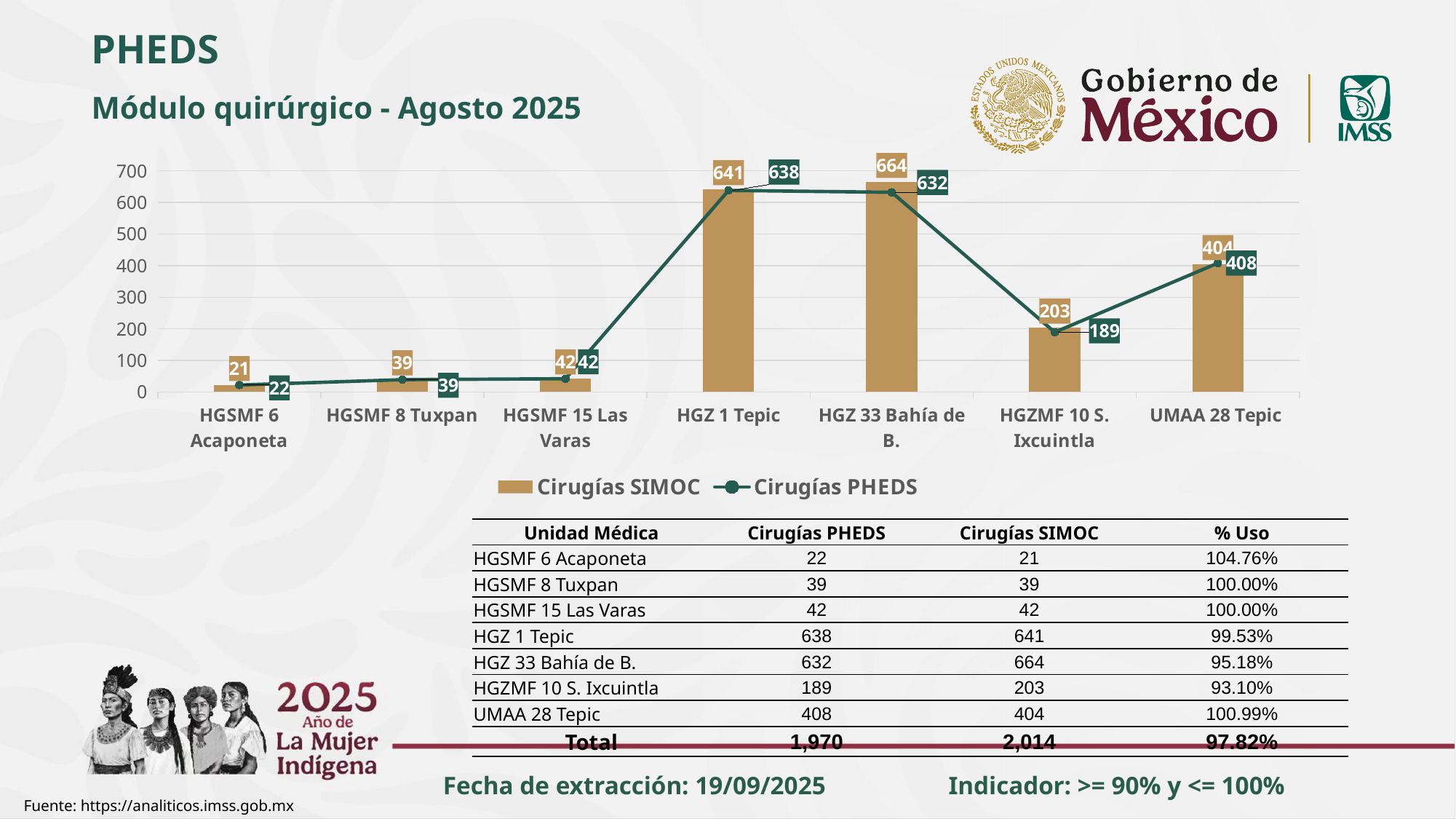
What kind of chart is used to show Cirugías SIMOC? Bar chart What is the Cirugías PHEDS value for HGZMF 10 S. Ixcuintla? 189 Which series is drawn as a line in the chart? Cirugías PHEDS What is the difference between Cirugías SIMOC and Cirugías PHEDS for HGZ 33 Bahía de B.? 32 What is the difference between Cirugías SIMOC for HGZ 1 Tepic and for UMAA 28 Tepic? 237 What is the Cirugías PHEDS value for HGSMF 6 Acaponeta? 22 How many medical units are shown on the x axis of the chart? 7 Which unit has the highest Cirugías SIMOC value? HGZ 33 Bahía de B. What is the Cirugías SIMOC value for HGZ 33 Bahía de B.? 664 Which unit has the lowest Cirugías PHEDS value? HGSMF 6 Acaponeta Which is larger for UMAA 28 Tepic: Cirugías SIMOC or Cirugías PHEDS? Cirugías PHEDS How many series does the chart legend list? 2